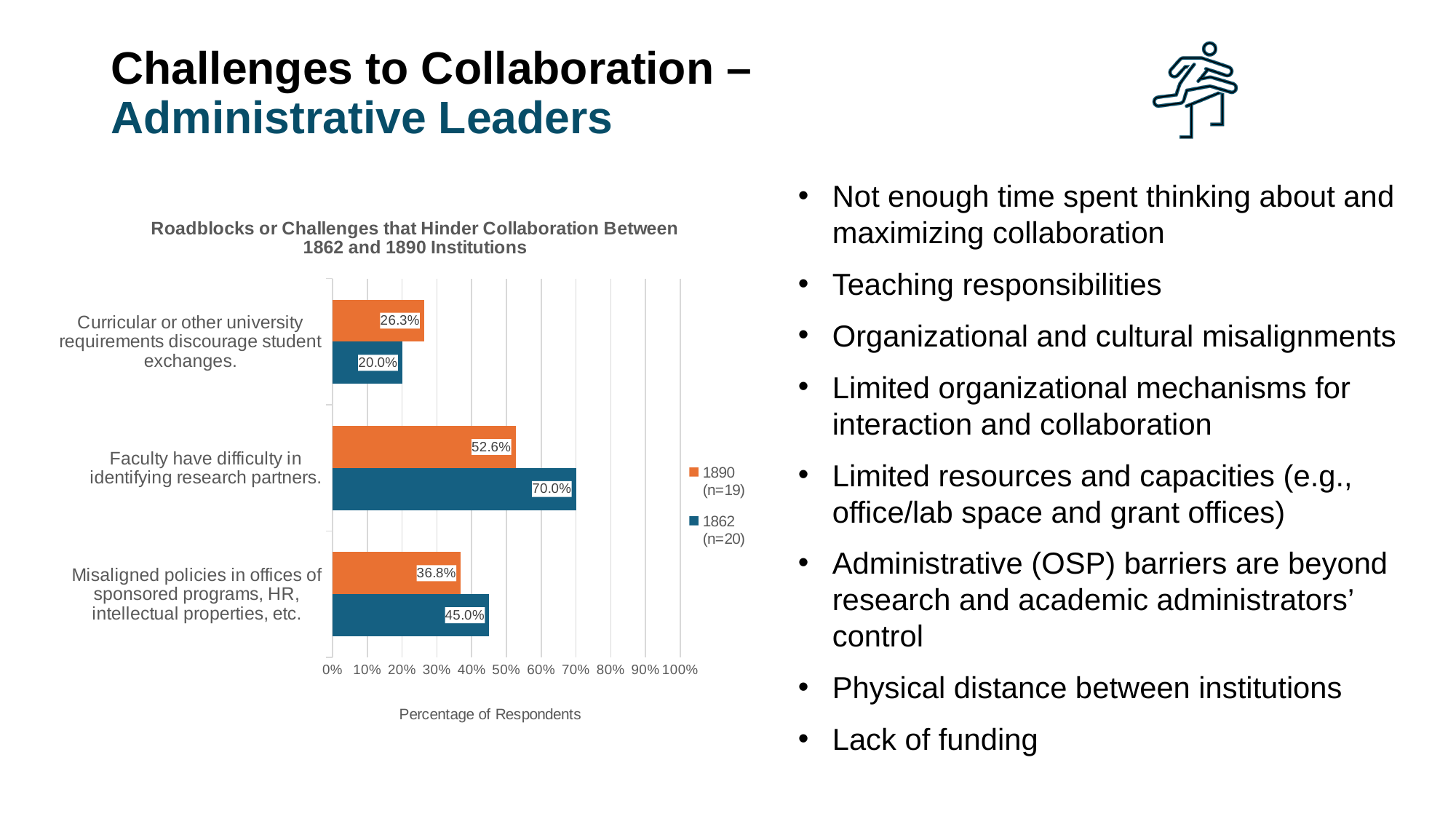
What is the sample size (n) for the 1890 series shown in the legend? n=19 Is the 1890 value for 'Curricular or other university requirements discourage student exchanges' greater or less than 30%? less What type of chart is shown on the slide? Bar chart Which roadblock has the highest percentage among 1862 respondents? Faculty have difficulty in identifying research partners. What percentage of 1862 respondents cited 'Misaligned policies in offices of sponsored programs, HR, intellectual properties, etc.' as a roadblock? 45.0% What percentage of 1890 respondents cited 'Faculty have difficulty in identifying research partners' as a roadblock? 52.6% Which roadblock has the lowest percentage among 1890 respondents? Curricular or other university requirements discourage student exchanges. For 'Misaligned policies in offices of sponsored programs, HR, intellectual properties, etc.', which series has the larger value, 1890 or 1862? 1862 How many roadblock categories are shown in the chart? 3 What is the difference between the 1862 and 1890 values for 'Faculty have difficulty in identifying research partners'? 17.4% What is the value for the 1862 series for 'Curricular or other university requirements discourage student exchanges.'? 20.0% How many series does the chart legend list? 2